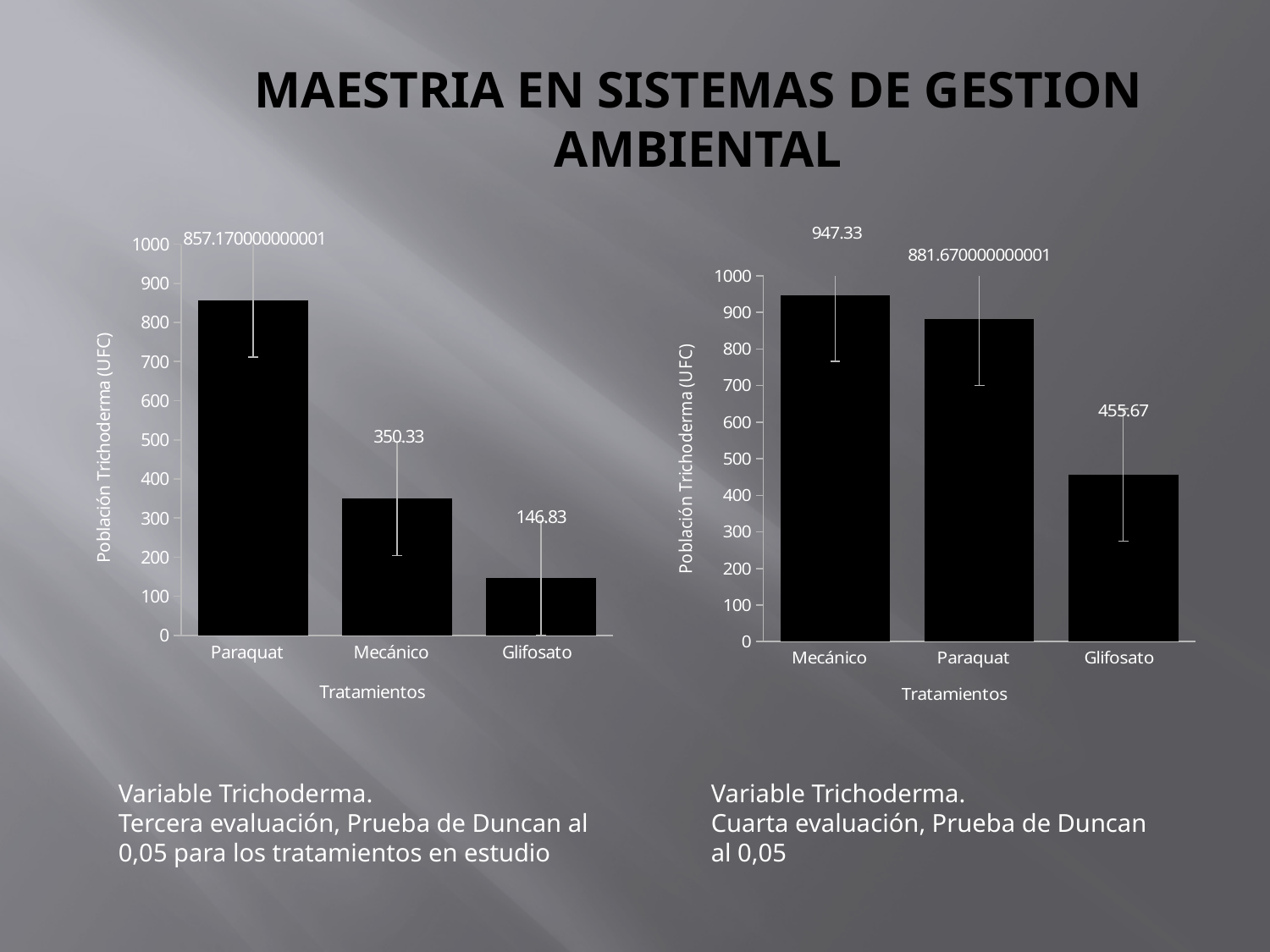
In the right chart (Cuarta evaluación), what is the value for Glifosato? 455.67 In the right chart (Cuarta evaluación), which treatment has the highest value? Mecánico What is the y-axis label of the left chart (Tercera evaluación)? Población Trichoderma (UFC) In the right chart (Cuarta evaluación), what is the value for Mecánico? 947.33 How many treatments are shown on the x axis of the left chart (Tercera evaluación)? 3 In the left chart (Tercera evaluación), what is the difference between the values for Mecánico and Glifosato? 203.5 What kind of chart is the right chart (Cuarta evaluación)? Bar chart In the right chart (Cuarta evaluación), which is larger, the value for Paraquat or the value for Glifosato? Paraquat In the left chart (Tercera evaluación), which treatment has the lowest value? Glifosato In the right chart (Cuarta evaluación), what is the difference between the values for Mecánico and Glifosato? 491.66 In the left chart (Tercera evaluación), what is the value for Mecánico? 350.33 In the left chart (Tercera evaluación), what is the value for Paraquat? 857.170000000001